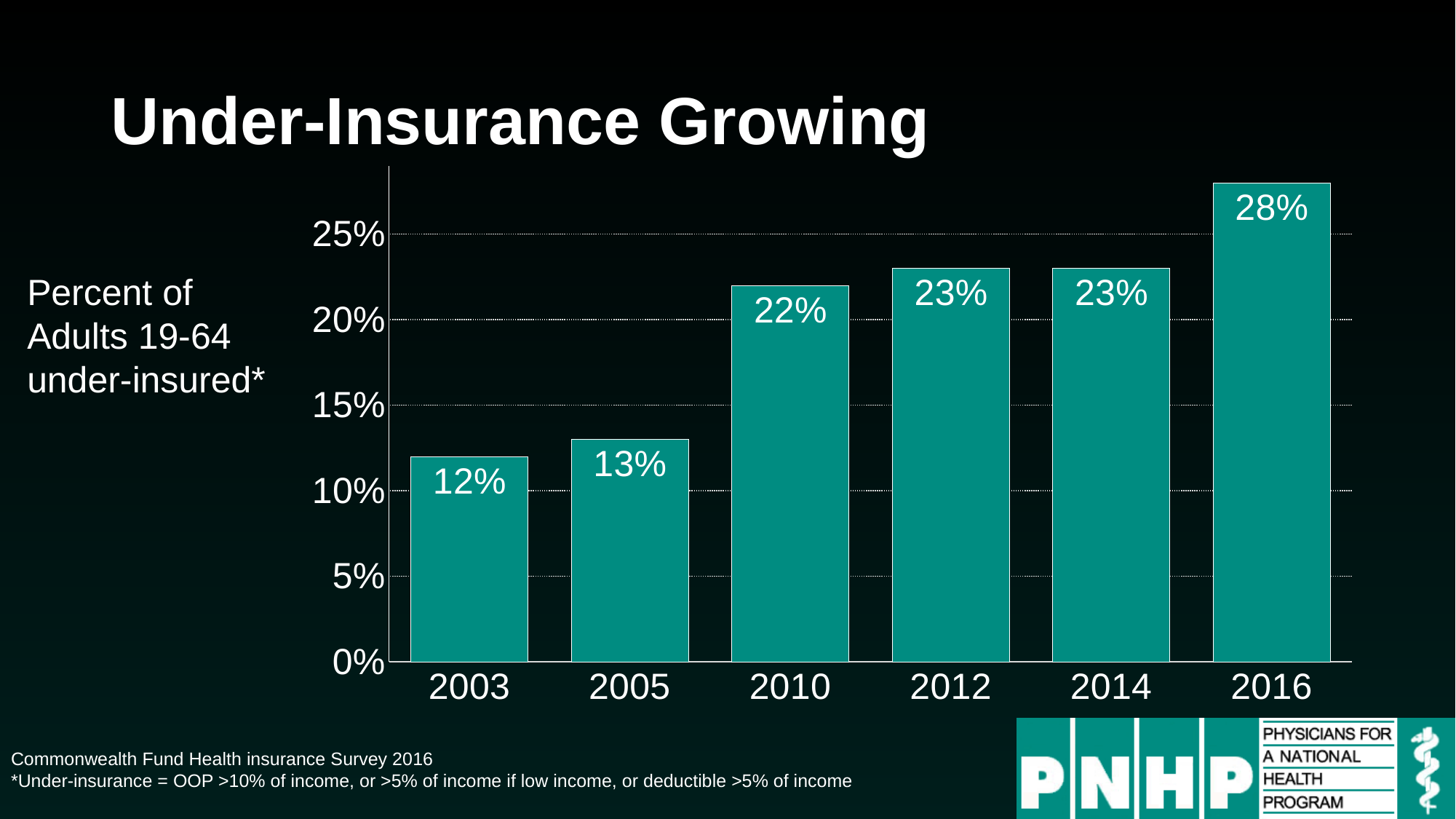
What is the difference between the 2010 value and the 2005 value? 9% Which year has the lowest percentage of under-insured adults? 2003 How many years are shown on the x axis? 6 What is the value shown for 2016? 28% Which is larger, the value for 2005 or the value for 2012? 2012 Is the value for 2014 greater or less than 20%? greater Do the values generally rise or fall from 2003 to 2016? Rise What kind of chart is shown on the slide? Bar chart What is the value shown for 2010? 22% What is the difference between the 2016 value and the 2003 value? 16% What percent of adults 19-64 were under-insured in 2003? 12% Which year has the highest percentage of under-insured adults? 2016